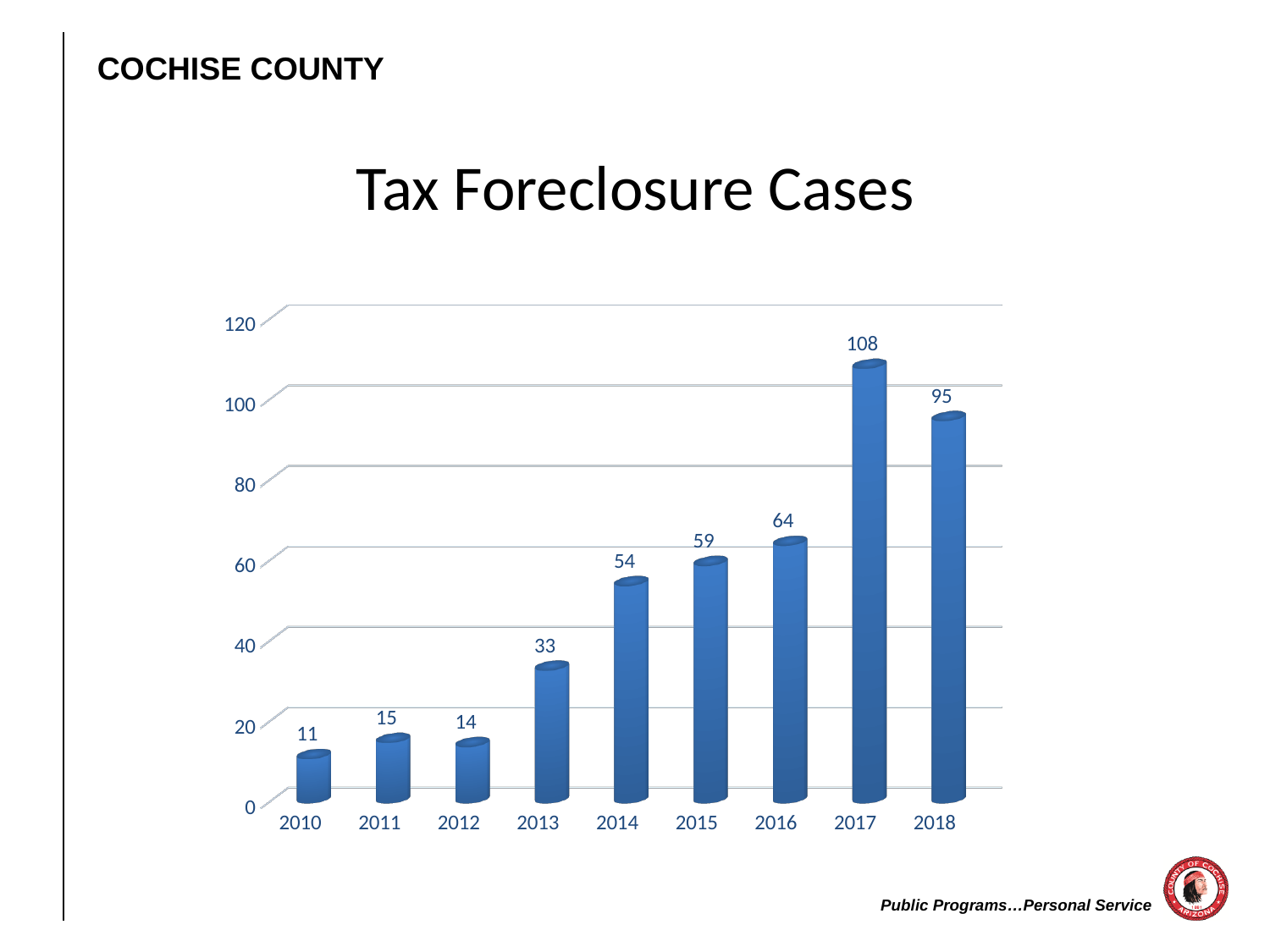
Which year has the highest number of tax foreclosure cases? 2017 What kind of chart is shown on the slide? bar chart What is the number of tax foreclosure cases in 2018? 95 What is the difference in tax foreclosure cases between 2013 and 2012? 19 What is the number of tax foreclosure cases in 2014? 54 Which year had more tax foreclosure cases, 2015 or 2016? 2016 Which year has the lowest number of tax foreclosure cases? 2010 How many years are shown on the x axis of the chart? 9 What is the number of tax foreclosure cases in 2010? 11 Is the value for 2017 greater or less than 100? greater What is the title of the chart? Tax Foreclosure Cases What is the difference in tax foreclosure cases between 2017 and 2018? 13